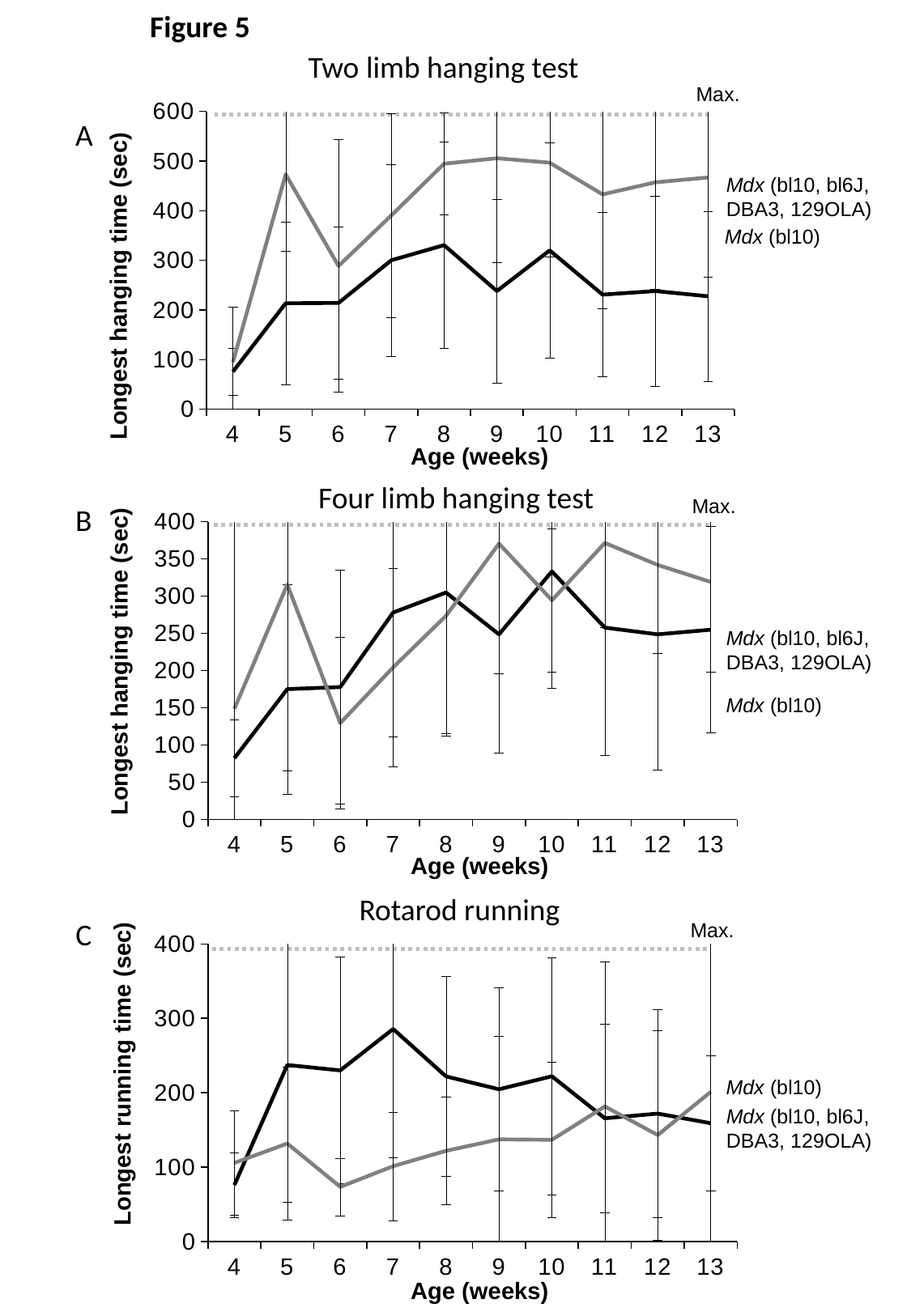
What does the dotted horizontal line at the top of each chart represent, according to its label? Max. In the 'Two limb hanging test' chart, at which age is the Mdx (bl10) line lowest? 4 weeks In the 'Rotarod running' chart, at which age is the Mdx (bl10) line highest? 7 weeks How many series does the legend of the 'Four limb hanging test' chart list? 2 In the 'Two limb hanging test' chart, is the value for Mdx (bl10, bl6J, DBA3, 129OLA) at 9 weeks greater or less than 400? greater What kind of chart is the 'Two limb hanging test' chart? line chart In the 'Four limb hanging test' chart, is the value for Mdx (bl10) at 4 weeks greater or less than 100? less In the 'Two limb hanging test' chart, is the value for Mdx (bl10) at 4 weeks greater or less than 100? less In the 'Two limb hanging test' chart, which series has the larger value at 9 weeks? Mdx (bl10, bl6J, DBA3, 129OLA) In the 'Rotarod running' chart, which series has the larger value at 7 weeks? Mdx (bl10) How many age points are plotted along the x axis of the 'Rotarod running' chart? 10 In the 'Four limb hanging test' chart, at which age is the Mdx (bl10, bl6J, DBA3, 129OLA) line lowest? 6 weeks